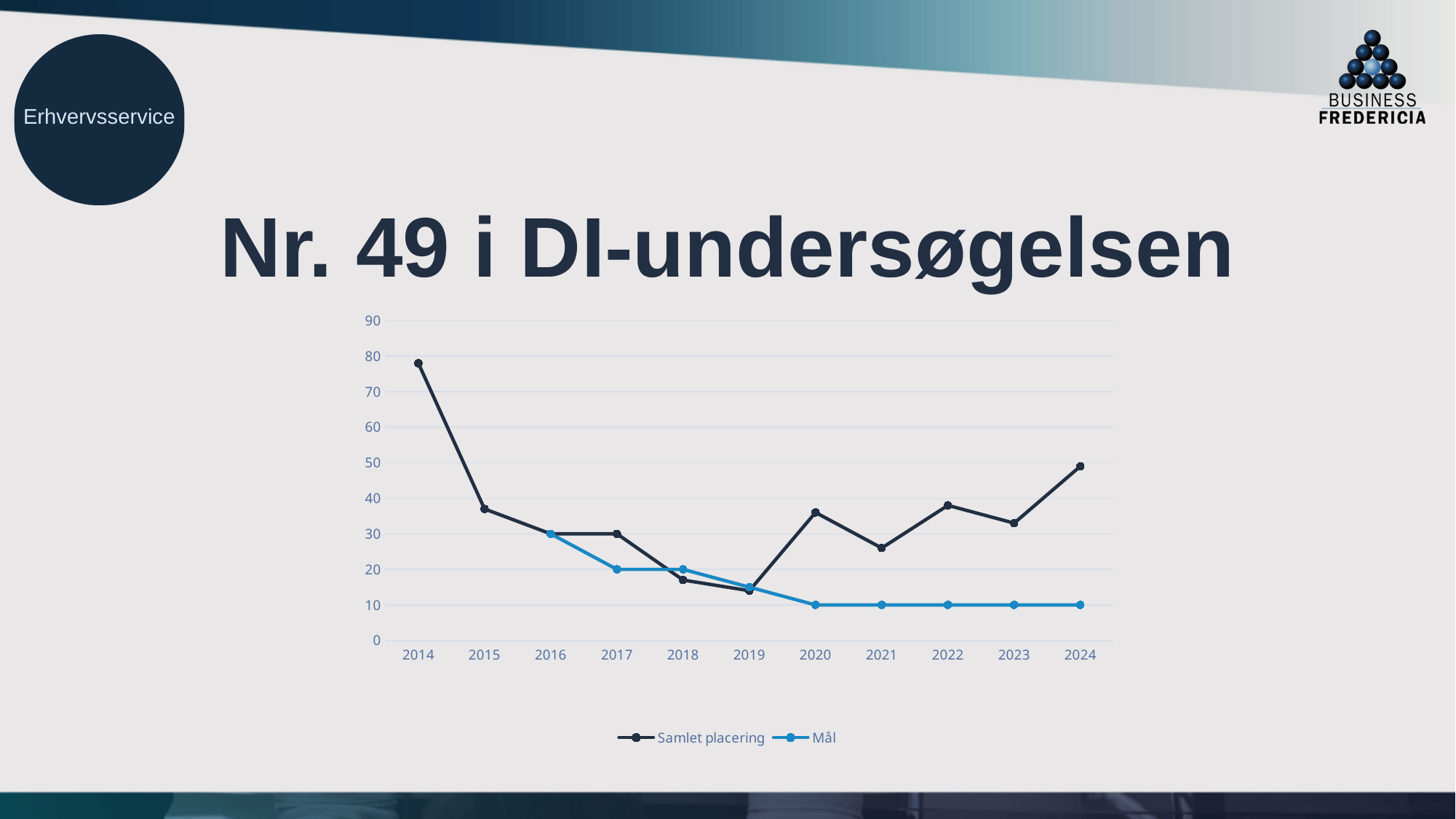
Which is larger for Samlet placering, the value in 2020 or in 2021? 2020 What kind of chart is shown on the slide? line chart In which year is Samlet placering highest? 2014 What is the value of Mål in 2020? 10 Is the value for Samlet placering in 2024 greater or less than 40? greater What is the value of Samlet placering in 2017? 30 Is the value for Samlet placering in 2014 greater or less than 70? greater What is the value of Mål in 2016? 30 What is the difference between the Mål value in 2016 and in 2020? 20 How many series does the legend list? 2 Does the Mål series rise or fall from 2016 to 2020? fall How many years are shown on the x axis? 11